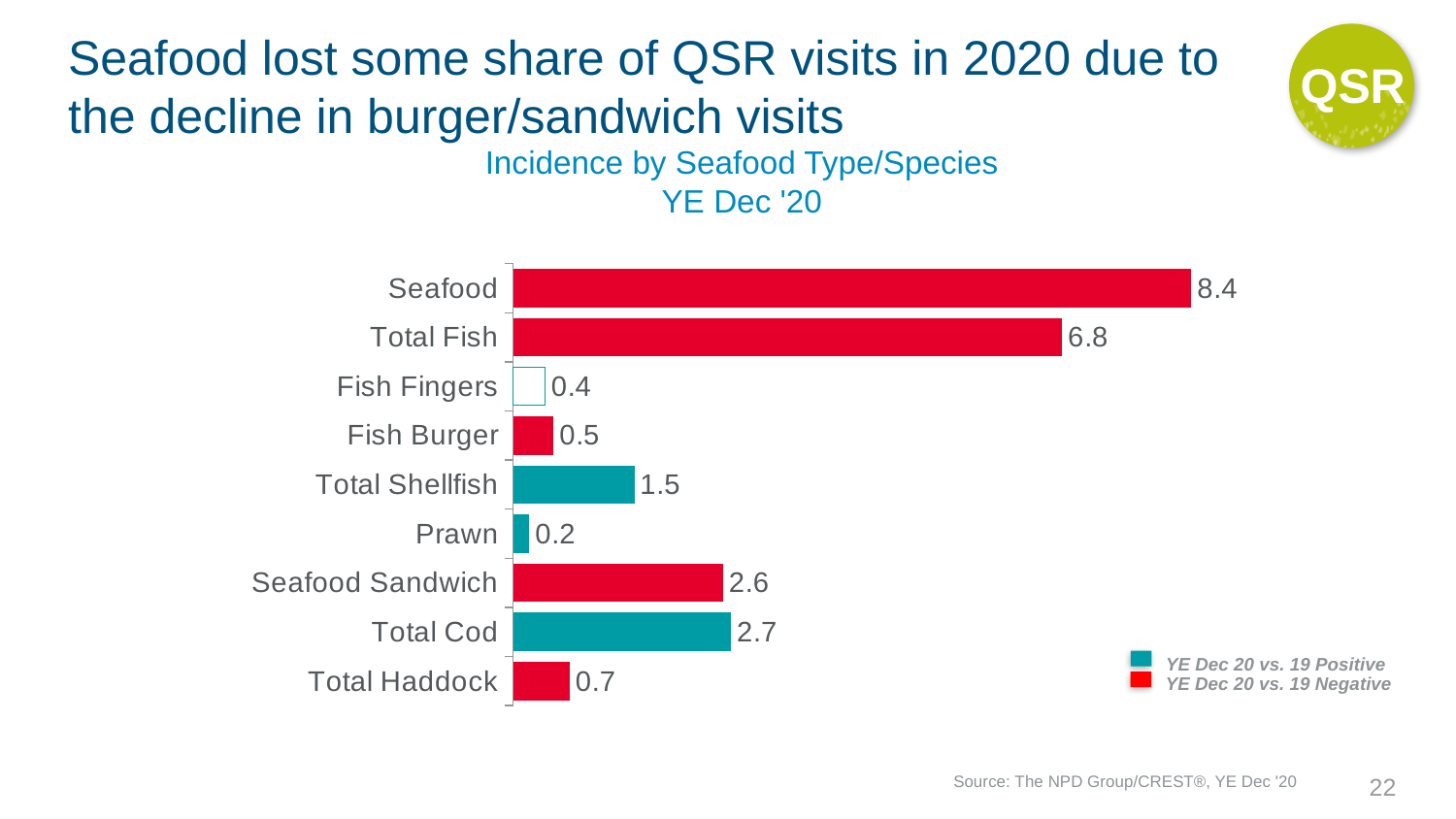
What is the value for Seafood? 8.4 What is the value for Total Shellfish? 1.5 How many categories are shown on the chart? 9 What is the title of the chart? Incidence by Seafood Type/Species YE Dec '20 What is the difference between the values for Seafood and Total Fish? 1.6 What is the value for Total Cod? 2.7 What is the difference between the values for Total Shellfish and Prawn? 1.3 Which category has the lowest value? Prawn What kind of chart is shown on the slide? Bar chart Which is larger, the value for Fish Burger or the value for Total Haddock? Total Haddock How many entries does the legend list? 2 Which category has the highest value? Seafood